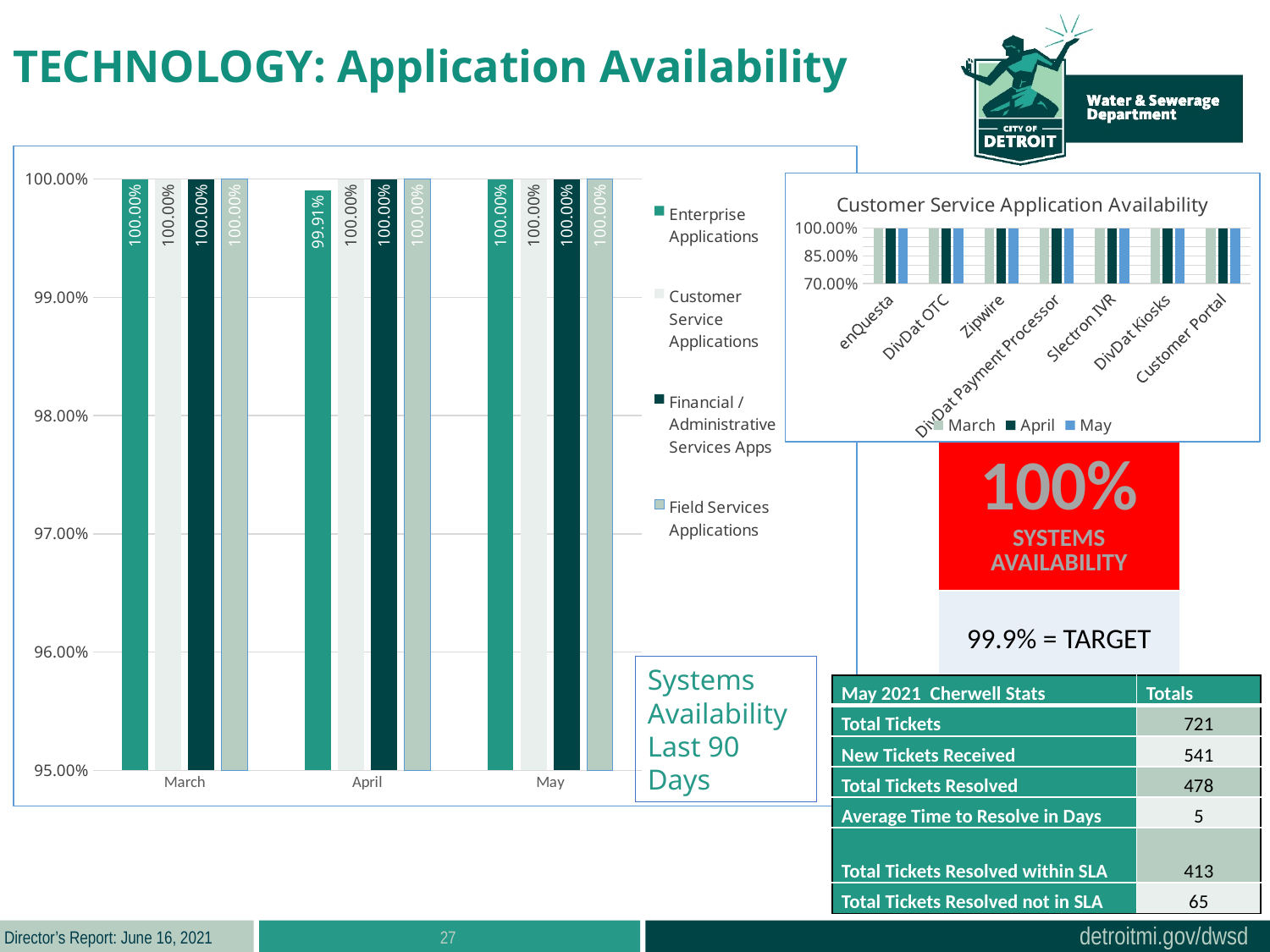
In the Systems Availability Last 90 Days chart, which month has the lowest value for Enterprise Applications? April How many applications are shown on the x axis of the Customer Service Application Availability chart? 7 In the Systems Availability Last 90 Days chart, what is the value for Field Services Applications in May? 100.00% What kind of chart is the Systems Availability Last 90 Days chart? Bar chart In the Systems Availability Last 90 Days chart, what is the value for Customer Service Applications in March? 100.00% In the Systems Availability Last 90 Days chart, what is the value for Enterprise Applications in April? 99.91% How many series does the legend of the Customer Service Application Availability chart list? 3 In the Systems Availability Last 90 Days chart, what is the difference between the Enterprise Applications value in March and in April? 0.09% How many series does the legend of the Systems Availability Last 90 Days chart list? 4 How many months are shown on the x axis of the Systems Availability Last 90 Days chart? 3 In the Systems Availability Last 90 Days chart, which is larger: Enterprise Applications in April or Financial / Administrative Services Apps in April? Financial / Administrative Services Apps in April In the Customer Service Application Availability chart, is the value for Zipwire in May greater or less than 85.00%? greater